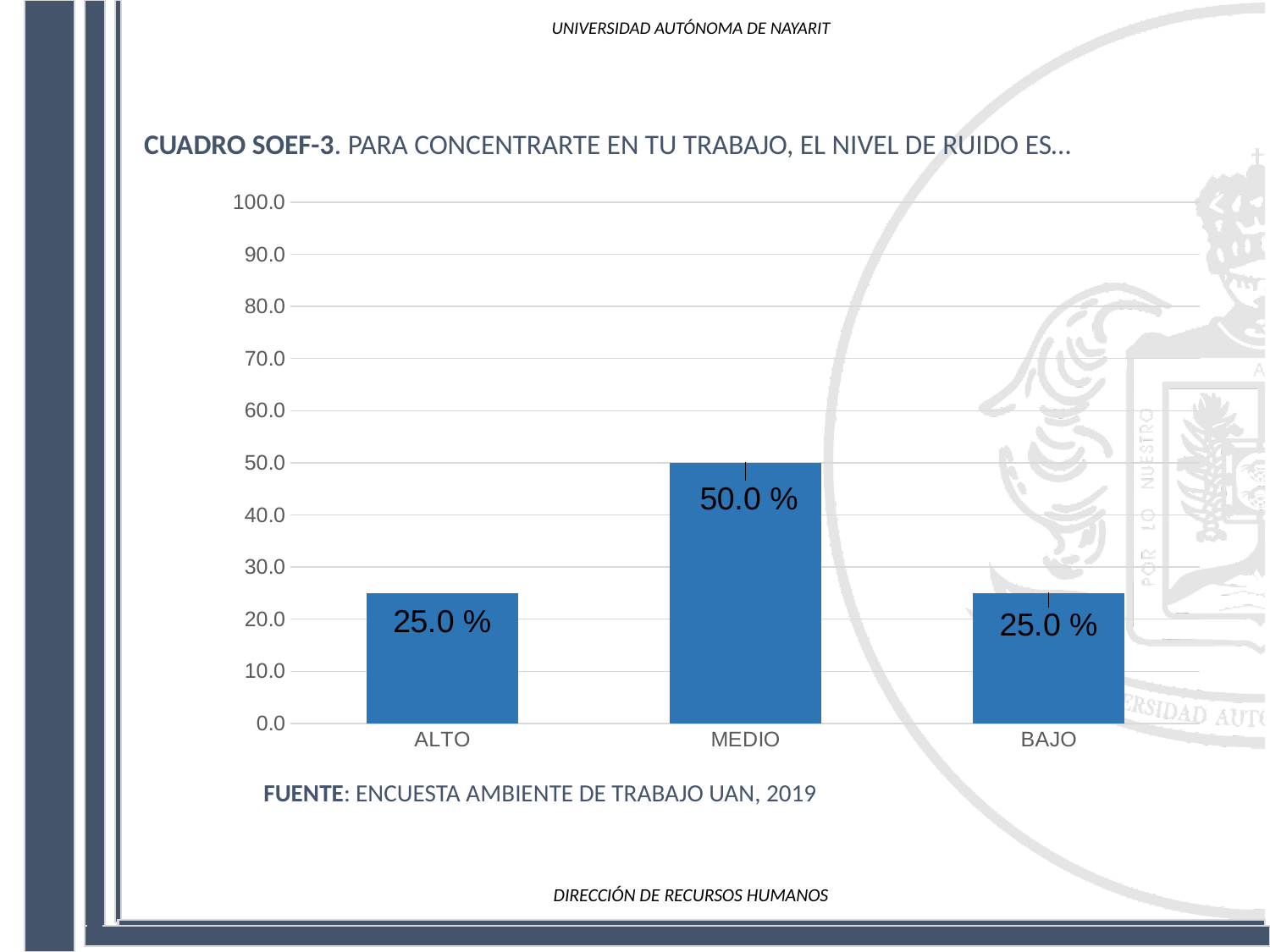
What is the value for BAJO? 25.0 % What is the difference between the values for MEDIO and ALTO? 25.0 % Is the value for MEDIO greater or less than 40.0? greater Which category has the highest value? MEDIO What is the source cited below the chart? ENCUESTA AMBIENTE DE TRABAJO UAN, 2019 What kind of chart is shown on the slide? bar chart What is the maximum value shown on the y axis? 100.0 Which is larger, the value for MEDIO or the value for BAJO? MEDIO What is the value for ALTO? 25.0 % How many categories are shown on the x axis? 3 What is the value for MEDIO? 50.0 % Is the value for ALTO greater or less than 30.0? less